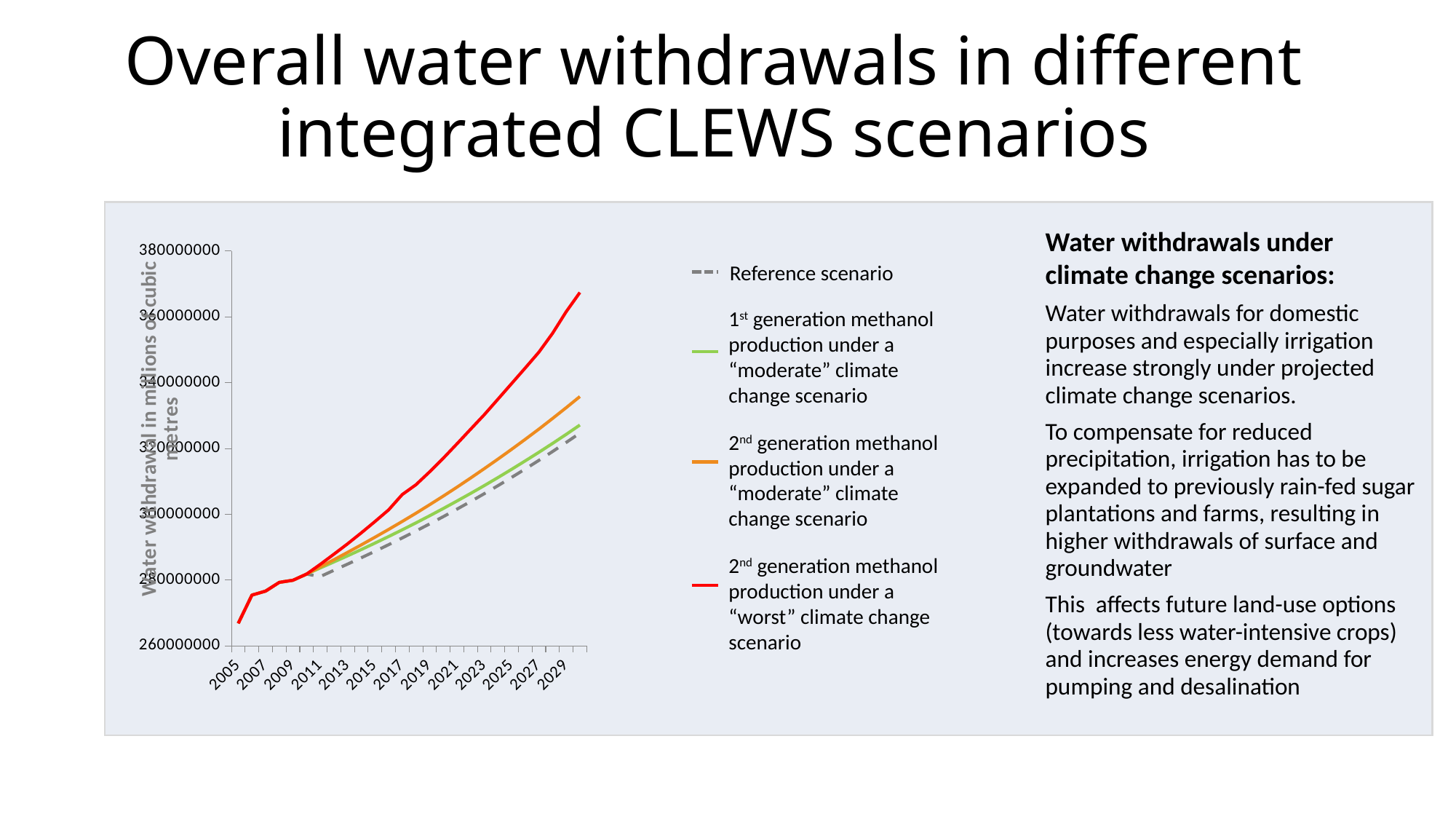
Which series is drawn as a dashed grey line? Reference scenario What kind of chart is shown on the slide? line chart At 2029, which is larger: the 2nd generation methanol "moderate" scenario (orange) or the 1st generation methanol "moderate" scenario (green)? 2nd generation methanol "moderate" scenario (orange) Which series reaches the highest value by 2029? 2nd generation methanol production under a "worst" climate change scenario Is the value of the "worst" climate change scenario (red line) at 2029 greater or less than 360000000? greater Which series has the lowest value at 2029? Reference scenario Do the water withdrawal values rise or fall from 2005 to 2029? rise Is the value of the 2nd generation methanol "moderate" climate scenario (orange line) at 2029 greater or less than 340000000? less How many series does the chart legend list? 4 Is the value of the Reference scenario at 2029 greater or less than 320000000? greater How many year labels are shown on the x axis? 13